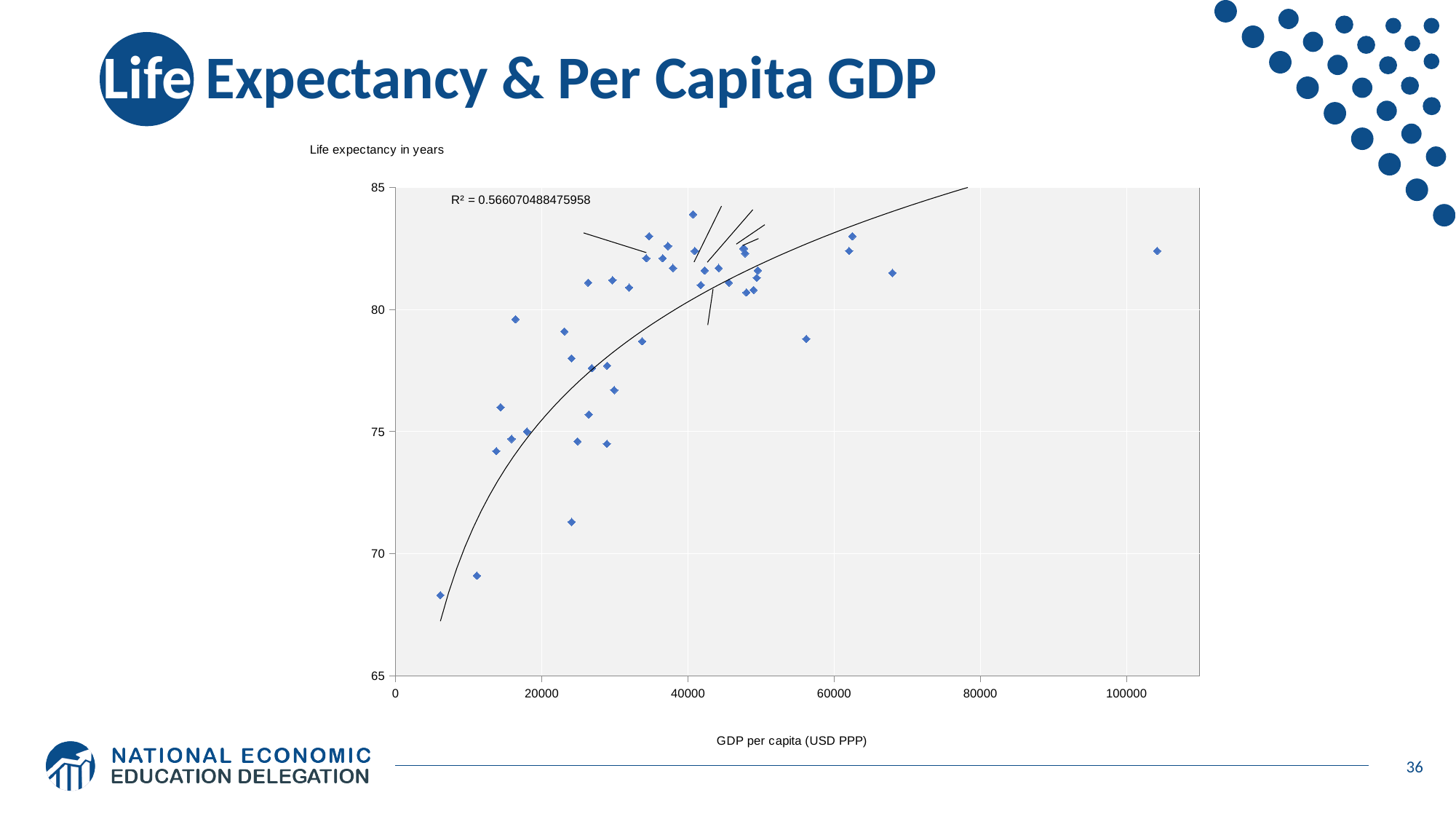
Is the life expectancy of the point with the highest GDP per capita greater or less than 80? greater Is the lowest GDP per capita plotted greater or less than 20000? less What kind of chart is shown on the slide? Scatter chart Which has the higher life expectancy: the point with GDP per capita just above 100000 or the point with GDP per capita near 56000? The point just above 100000 What is the label of the vertical axis? Life expectancy in years Is the lowest life expectancy plotted greater or less than 70? less According to the fitted curve, does life expectancy rise or fall as GDP per capita increases? Rise What is the label of the horizontal axis? GDP per capita (USD PPP) What R² value is printed on the chart? R² = 0.566070488475958